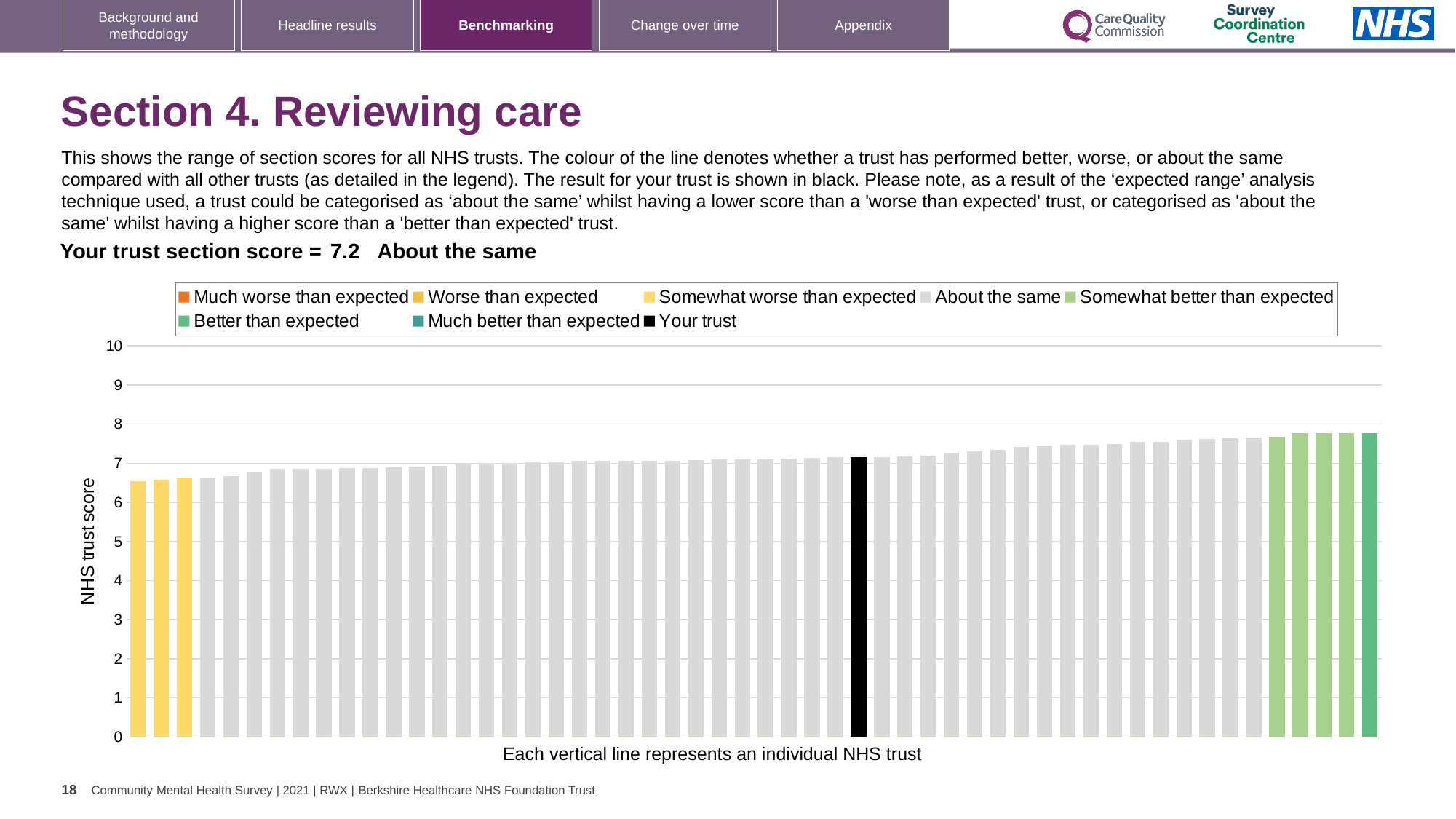
Is the value of the rightmost bar greater or less than 7? greater How many entries does the chart legend list? 8 Is the value for your trust greater or less than 5? greater What is the section score for your trust shown on the slide? 7.2 Do the bar values rise or fall from left to right along the x axis? Rise Is the value of the leftmost bar greater or less than 7? less Which is taller, the leftmost bar or the rightmost bar? The rightmost bar What kind of chart is shown on the slide? Bar chart What colour is the bar representing your trust? Black What is the label on the vertical axis of the chart? NHS trust score Which category is your trust placed in for this section? About the same